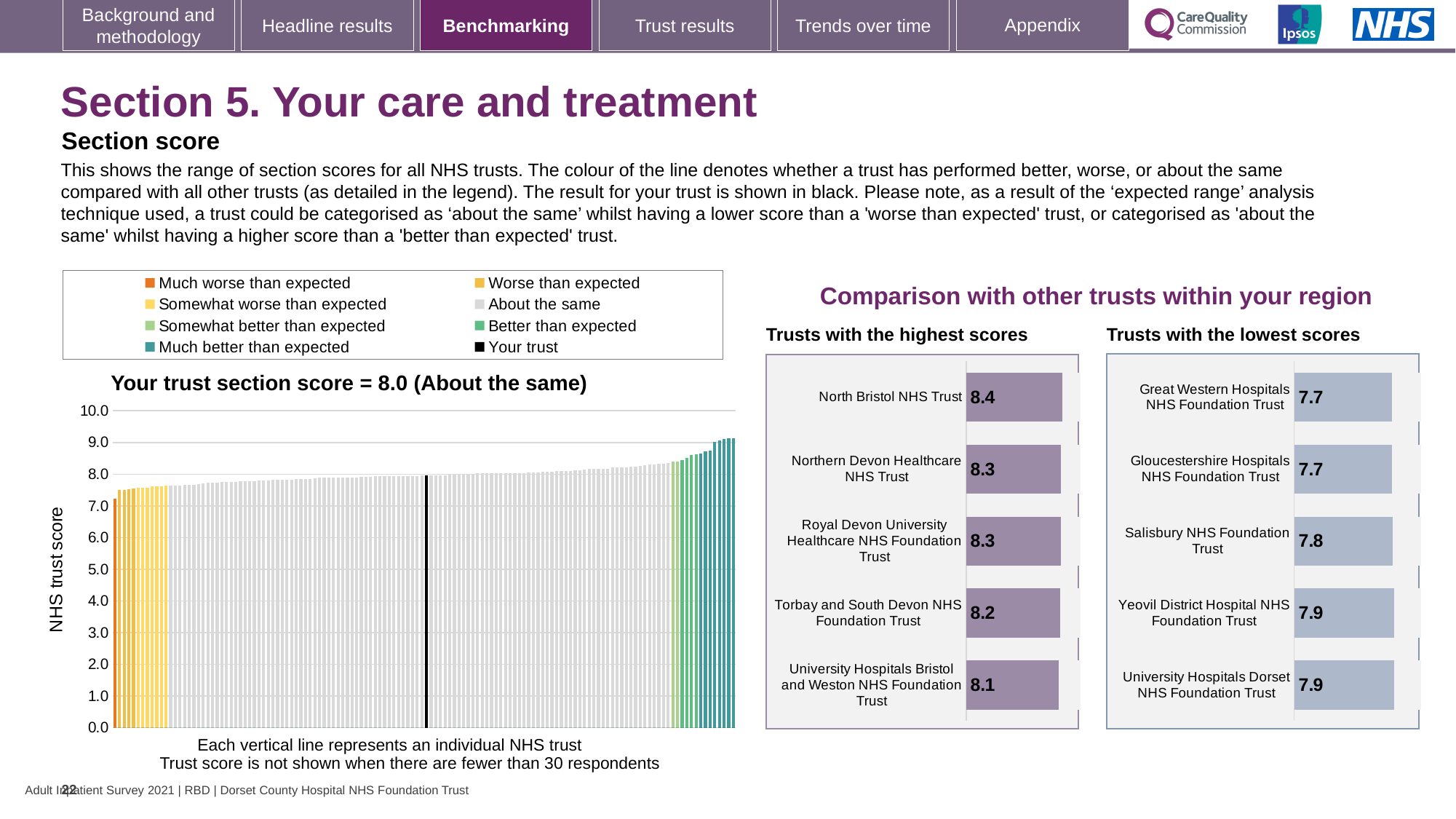
In the main chart on the left, do the trust scores rise or fall from left to right? Rise In the 'Trusts with the highest scores' chart, what is the score for Torbay and South Devon NHS Foundation Trust? 8.2 In the 'Trusts with the highest scores' chart, what is the score for North Bristol NHS Trust? 8.4 In the 'Trusts with the highest scores' chart, which trust has the highest score? North Bristol NHS Trust In the 'Trusts with the lowest scores' chart, what is the score for University Hospitals Dorset NHS Foundation Trust? 7.9 In the 'Trusts with the lowest scores' chart, which has the larger score: Salisbury NHS Foundation Trust or Great Western Hospitals NHS Foundation Trust? Salisbury NHS Foundation Trust What kind of chart is the main chart on the left showing the range of section scores? Bar chart In the 'Trusts with the highest scores' chart, which trust has the lowest score? University Hospitals Bristol and Weston NHS Foundation Trust According to the title of the main chart on the left, what is your trust's section score? 8.0 In the 'Trusts with the lowest scores' chart, what is the score for Salisbury NHS Foundation Trust? 7.8 In the 'Trusts with the highest scores' chart, what is the difference between the scores of North Bristol NHS Trust and University Hospitals Bristol and Weston NHS Foundation Trust? 0.3 How many trusts are listed in the 'Trusts with the lowest scores' chart? 5